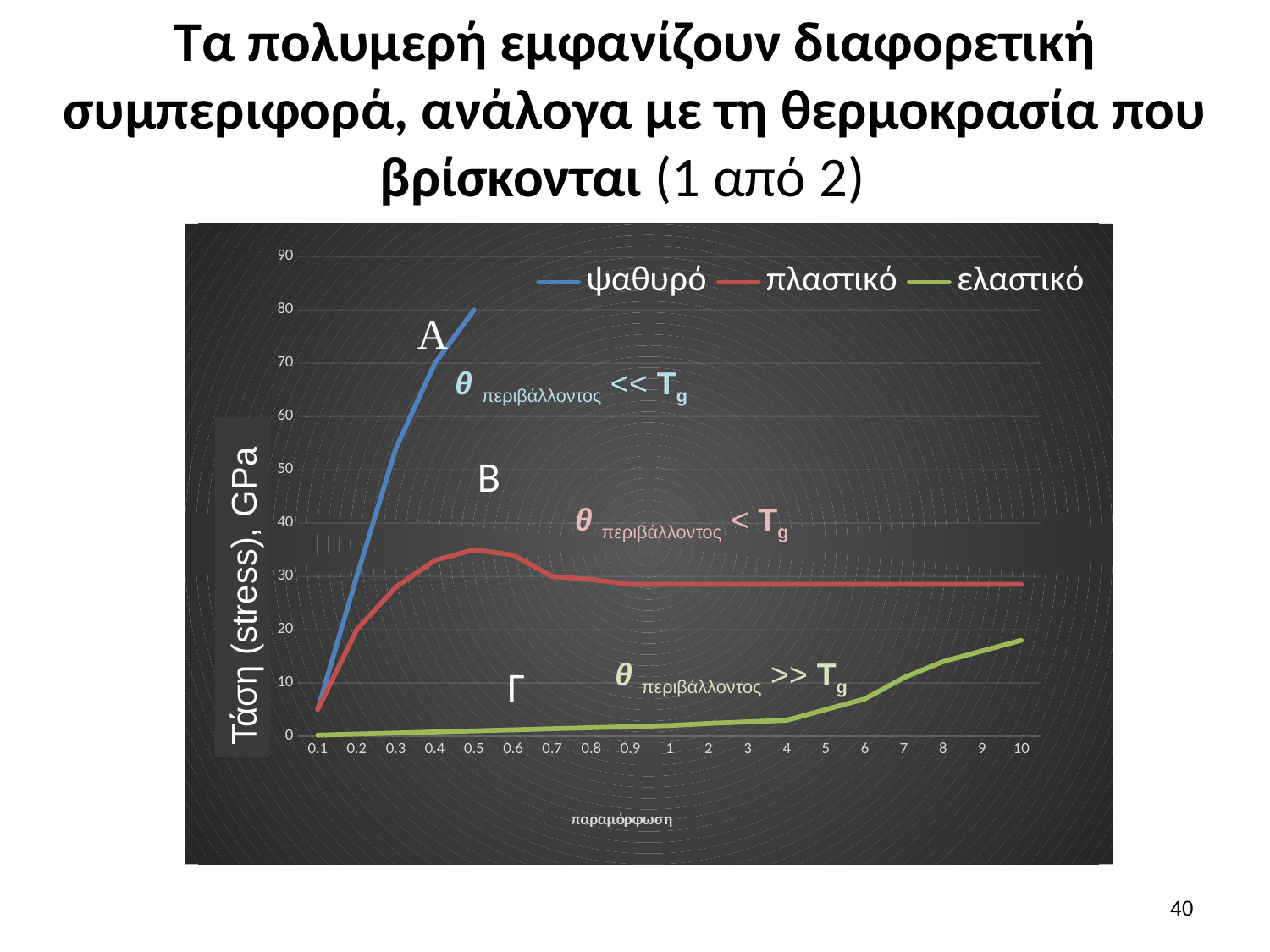
What are the three series named in the legend? ψαθυρό, πλαστικό, ελαστικό How many categories are shown on the x axis? 19 Is the value of the ελαστικό series at 1 greater or less than 10? less Does the ελαστικό series rise or fall along the x axis? rise Is the value of the ελαστικό series at 10 greater or less than 20? less Is the value of the πλαστικό series at 0.5 greater or less than 30? greater What kind of chart is shown on the slide? line chart How many series does the legend list? 3 At 0.3 on the x axis, which series has the larger value, ψαθυρό or πλαστικό? ψαθυρό What is the label of the vertical axis? Τάση (stress), GPa Which series reaches the highest value on the chart? ψαθυρό